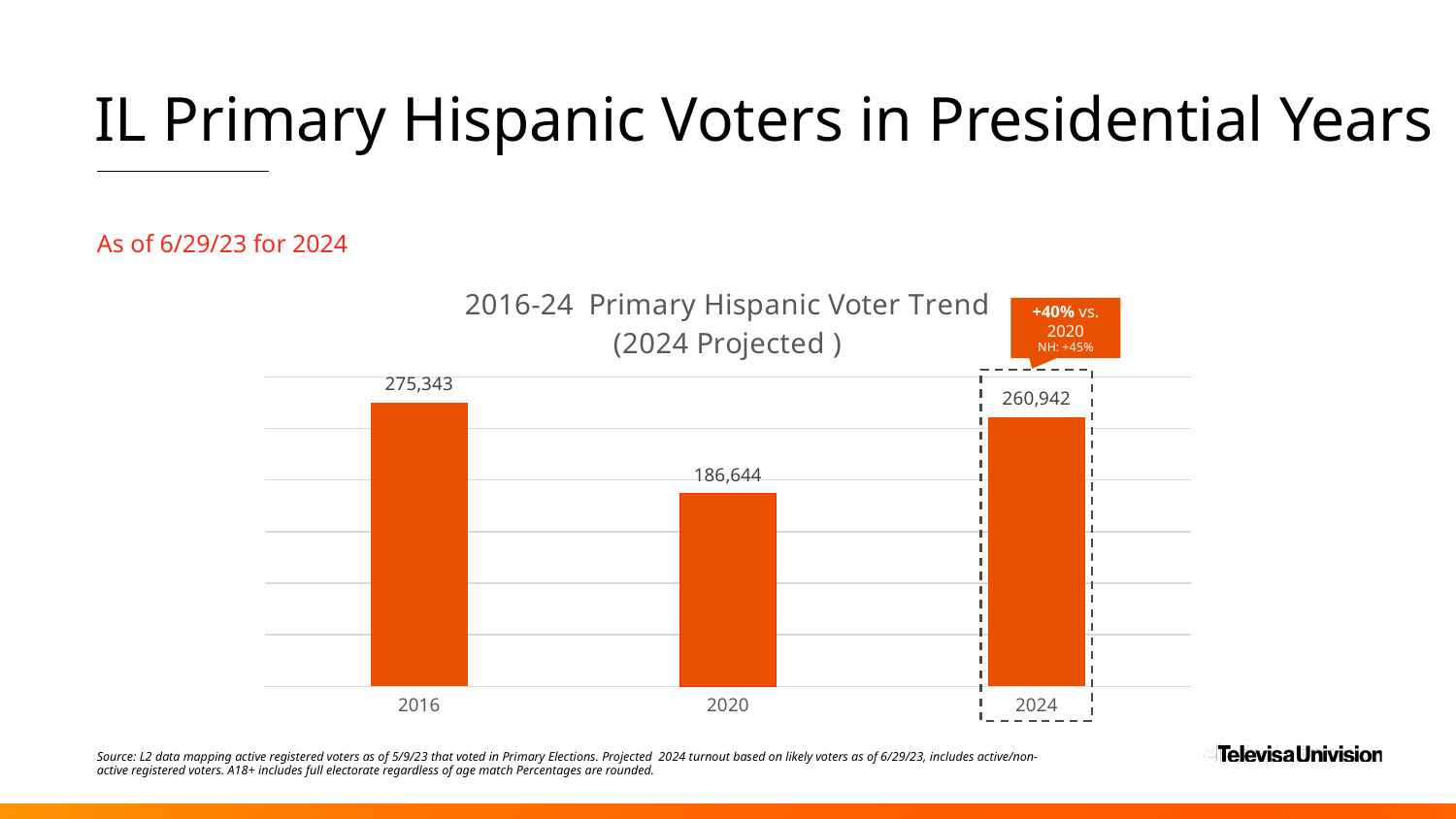
How many years are plotted in the chart? 3 What is the difference between the 2016 value and the 2020 value? 88,699 Which year has the highest value in the chart? 2016 Which year has the lowest value in the chart? 2020 What is the value for 2016 in the chart? 275,343 What is the value for 2020 in the chart? 186,644 What kind of chart is shown on the slide? Bar chart What is the difference between the 2024 projected value and the 2020 value? 74,298 What is the projected value for 2024 in the chart? 260,942 Which is larger, the value for 2016 or the value for 2024? 2016 Do the values rise or fall from 2016 to 2020? Fall What is the title of the chart? 2016-24 Primary Hispanic Voter Trend (2024 Projected )